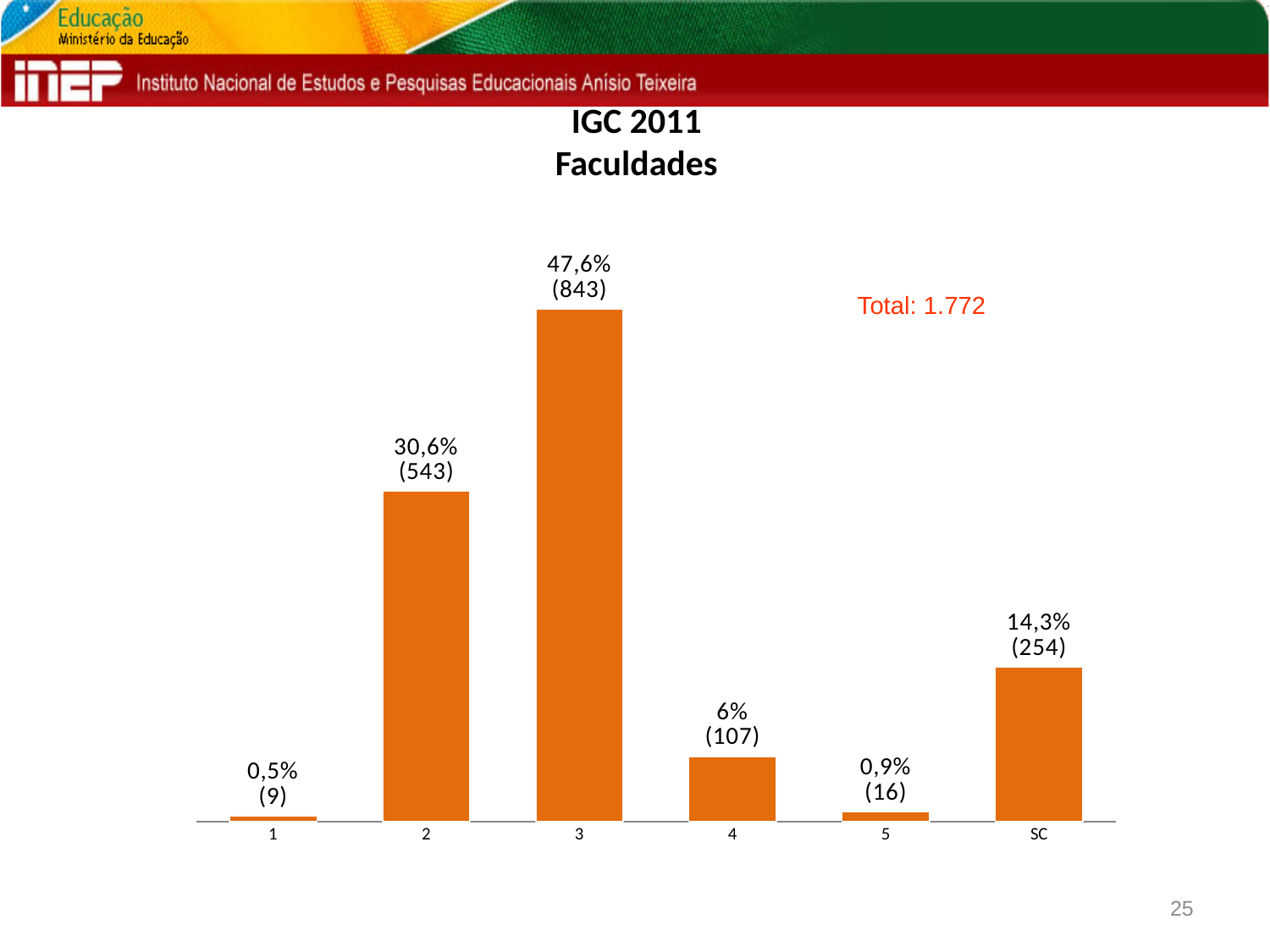
What kind of chart is this? bar chart Which category has the highest value? 3 Which is larger, the value for category 4 or the value for category SC? SC What count is shown in parentheses for category 5? 16 What is the difference in counts between category 3 and category 2? 300 What is the title of the chart? IGC 2011 Faculdades What total is stated on the slide? 1.772 How many categories are shown on the x axis? 6 Which category has the lowest value? 1 What count is shown in parentheses for category 2? 543 What percentage is shown for category 3? 47,6% What percentage is shown for category SC? 14,3%